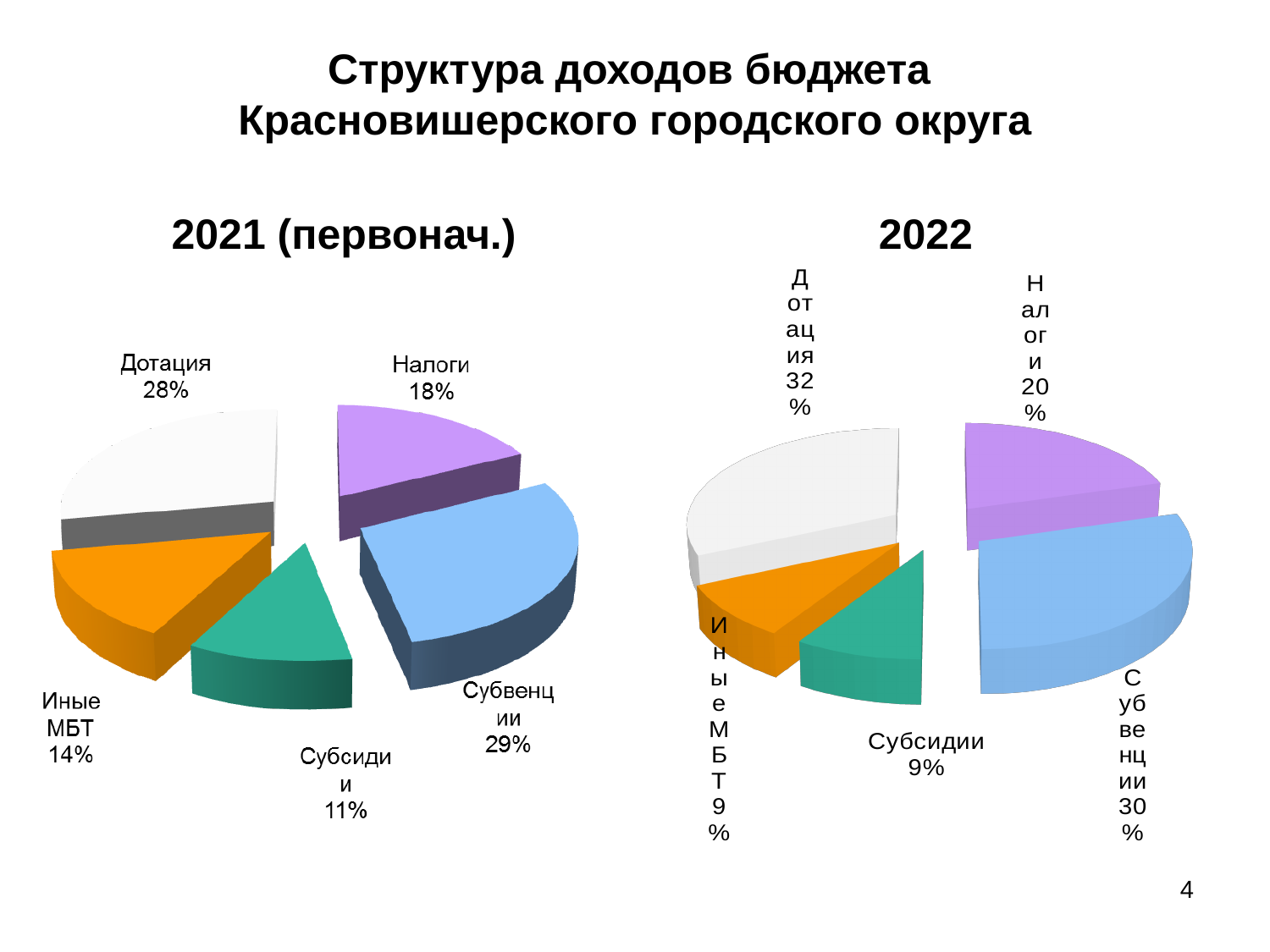
In the 2022 pie chart, which category has the largest share? Дотация What is the title of the slide? Структура доходов бюджета Красновишерского городского округа In the 2022 pie chart, what share is Субвенции? 30% How many slices does the 2021 (первонач.) pie chart have? 5 In the 2021 (первонач.) pie chart, which category has the largest share? Субвенции In the 2022 pie chart, which is larger: Налоги or Субсидии? Налоги In the 2021 (первонач.) pie chart, what share is Субсидии? 11% In the 2022 pie chart, what share is Дотация? 32% What is the difference in percentage points between Дотация in 2022 and Дотация in 2021 (первонач.)? 4 In the 2021 (первонач.) pie chart, what share is Дотация? 28% In the 2021 (первонач.) pie chart, which category has the smallest share? Субсидии What type of chart is used for 2022? Pie chart